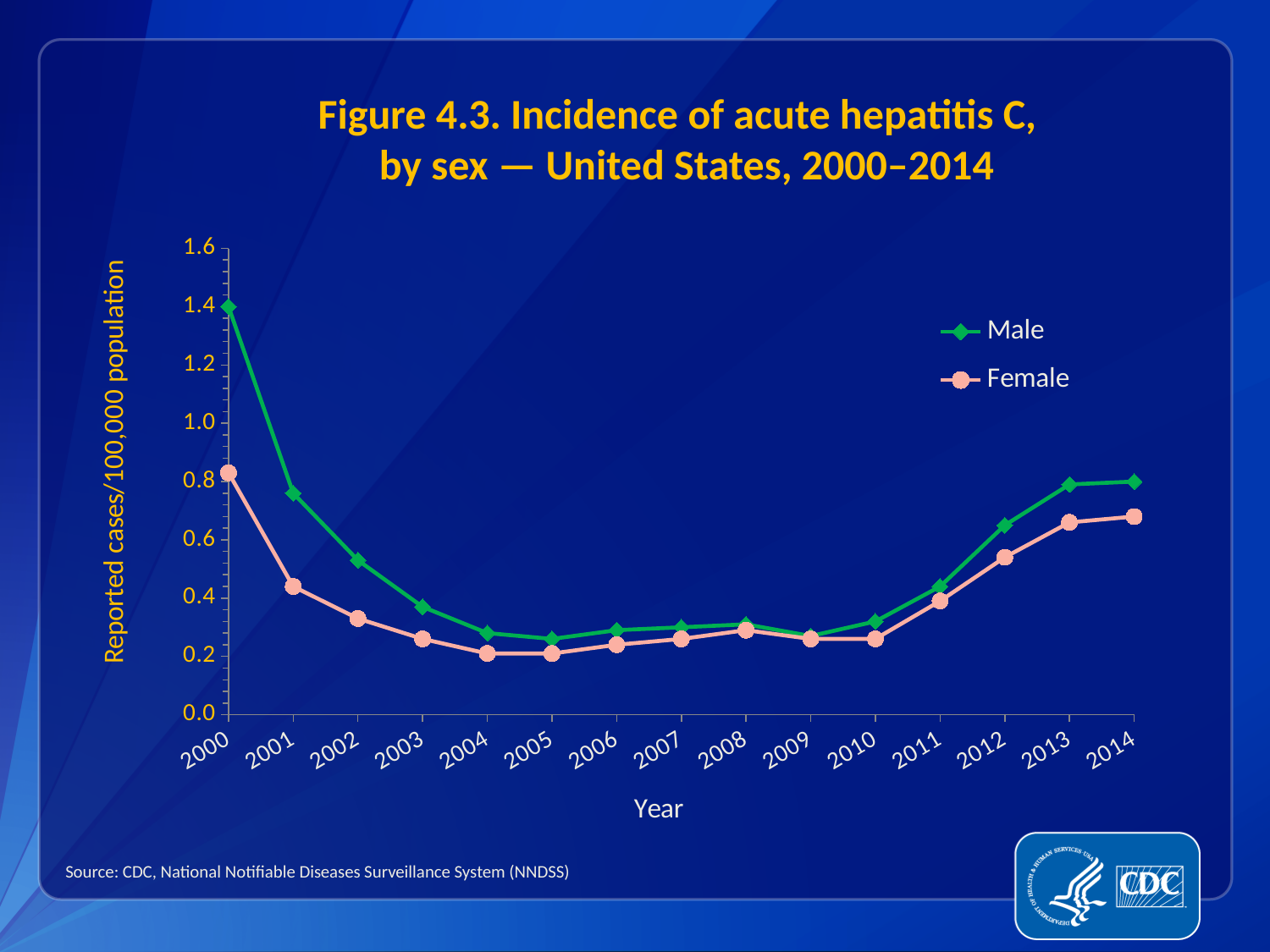
How many years are plotted along the x axis? 15 Is the Female value for 2014 greater or less than 0.6? greater Is the Male value for 2014 greater or less than 1.0? less What kind of chart is shown on the slide? line chart Is the Female value for 2000 greater or less than 0.6? greater In 2012, which series has the larger value, Male or Female? Male How many series does the legend list? 2 Which year has the highest value for the Female series? 2000 What is the label of the y axis? Reported cases/100,000 population Do the Male values rise or fall from 2000 to 2005? fall Which year has the highest value for the Male series? 2000